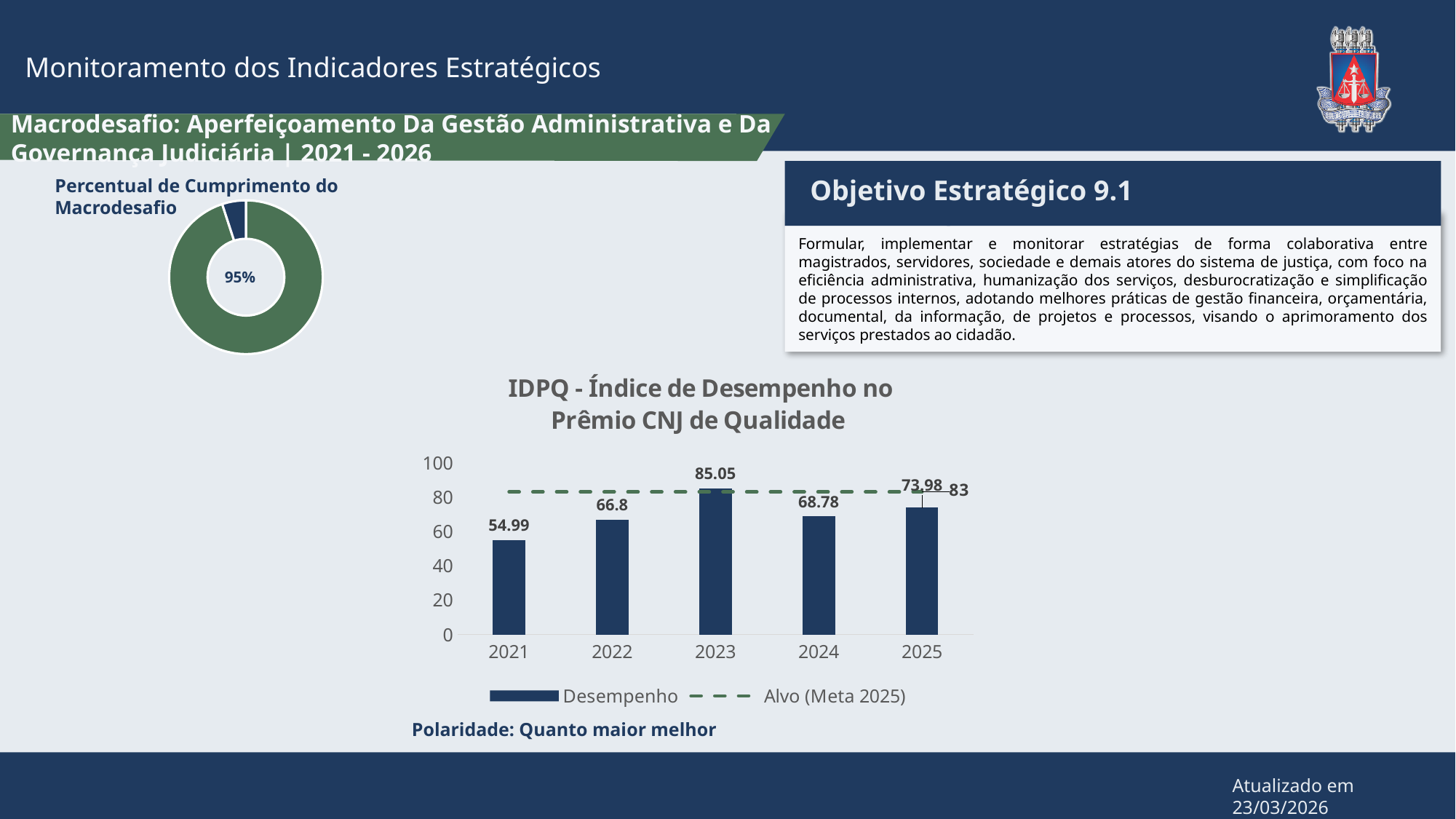
How many series does the legend of the IDPQ - Índice de Desempenho no Prêmio CNJ de Qualidade chart list? 2 In the IDPQ - Índice de Desempenho no Prêmio CNJ de Qualidade chart, which is larger, the Desempenho value for 2024 or for 2025? 2025 In the IDPQ - Índice de Desempenho no Prêmio CNJ de Qualidade chart, is the Desempenho value for 2022 greater or less than 60? greater In the IDPQ - Índice de Desempenho no Prêmio CNJ de Qualidade chart, which year has the highest Desempenho value? 2023 How many years are shown on the x axis of the IDPQ - Índice de Desempenho no Prêmio CNJ de Qualidade chart? 5 In the Percentual de Cumprimento do Macrodesafio chart, what percentage is shown in the centre? 95% In the IDPQ - Índice de Desempenho no Prêmio CNJ de Qualidade chart, what is the value of the Alvo (Meta 2025) line? 83 In the IDPQ - Índice de Desempenho no Prêmio CNJ de Qualidade chart, what is the Desempenho value for 2023? 85.05 In the IDPQ - Índice de Desempenho no Prêmio CNJ de Qualidade chart, which year has the lowest Desempenho value? 2021 In the IDPQ - Índice de Desempenho no Prêmio CNJ de Qualidade chart, what is the difference between the Desempenho values for 2023 and 2022? 18.25 What kind of chart is the Percentual de Cumprimento do Macrodesafio chart? Donut (pie) chart In the IDPQ - Índice de Desempenho no Prêmio CNJ de Qualidade chart, what is the Desempenho value for 2021? 54.99